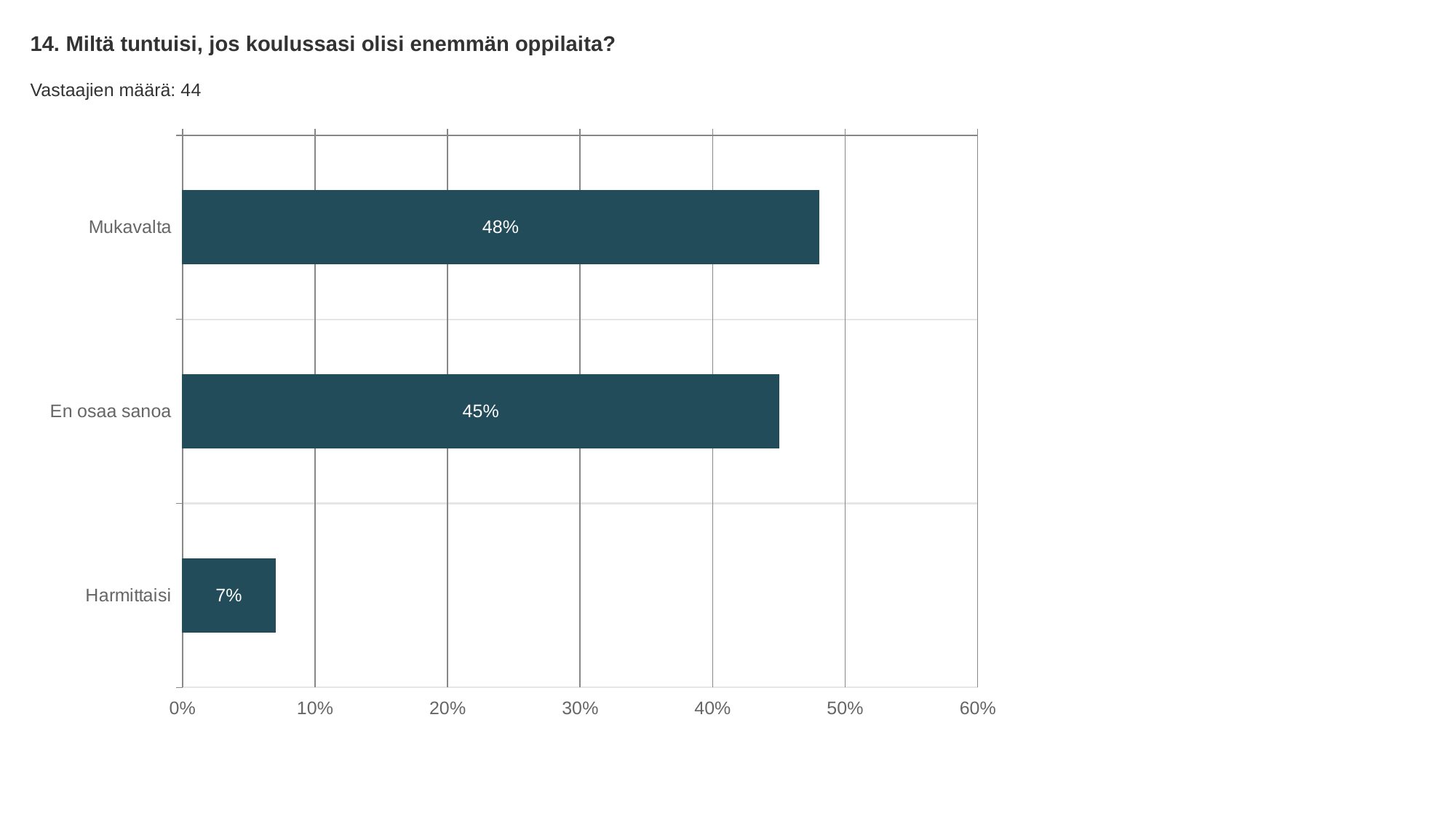
What is the value for Mukavalta? 48% Which is larger, the value for En osaa sanoa or the value for Harmittaisi? En osaa sanoa Is the value for Mukavalta greater or less than 40%? greater Which category has the lowest value? Harmittaisi What is the difference between the values for En osaa sanoa and Harmittaisi? 38% What is the value for En osaa sanoa? 45% What kind of chart is shown on the slide? bar chart How many categories are shown in the chart? 3 Which category has the highest value? Mukavalta How many respondents (Vastaajien määrä) does the slide report? 44 What is the value for Harmittaisi? 7% What is the difference between the values for Mukavalta and Harmittaisi? 41%